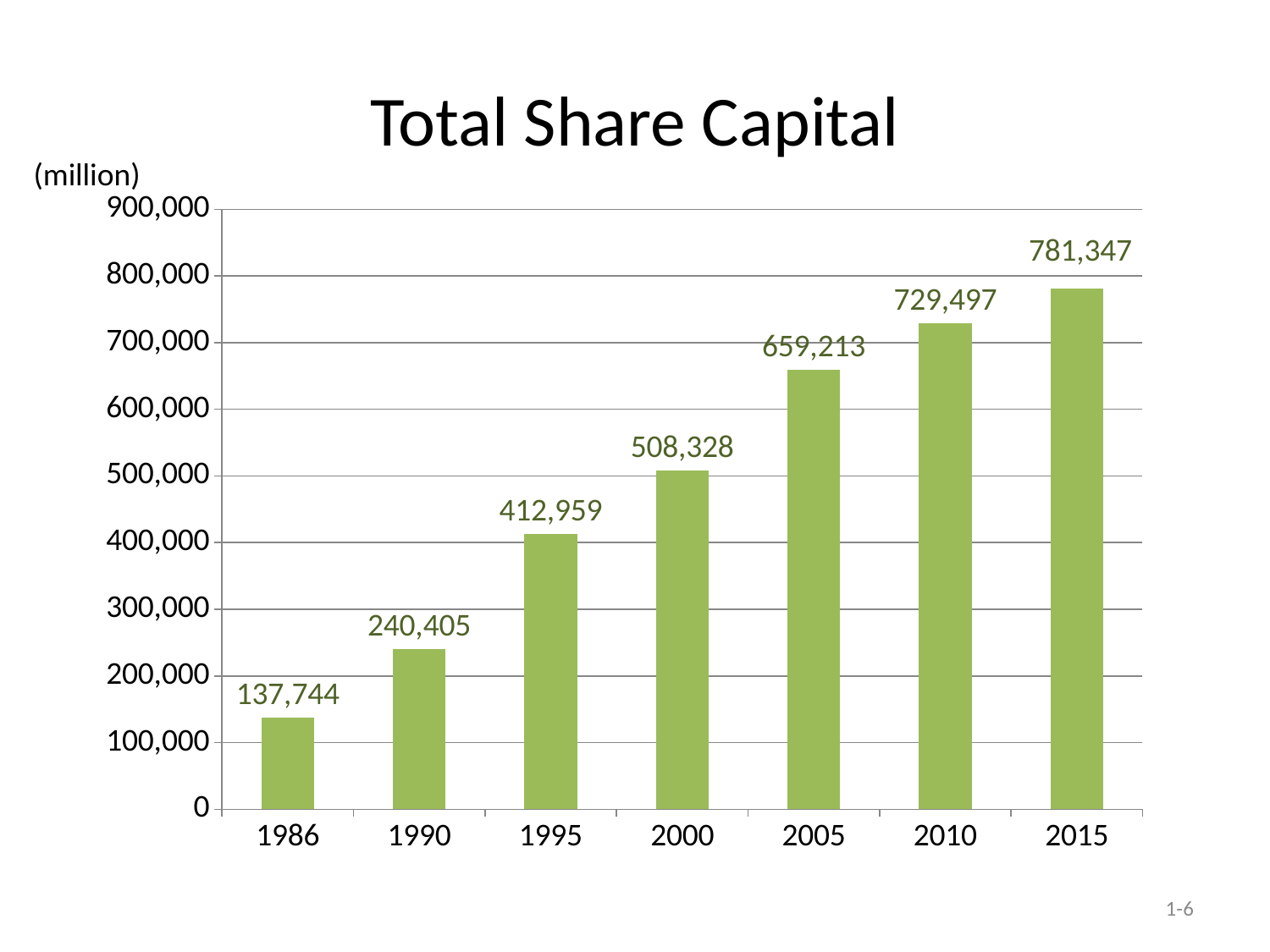
What is the difference between the total share capital in 2015 and in 2010? 51,850 Which year has a larger total share capital, 2005 or 2000? 2005 Do the values rise or fall from 1986 to 2015? Rise What kind of chart is shown on the slide? Bar chart What is the difference between the total share capital in 1995 and in 1990? 172,554 What is the total share capital for 1986? 137,744 How many years are shown on the chart? 7 Which year has the highest total share capital? 2015 What is the total share capital for 2010? 729,497 Is the value for 2005 greater or less than 600,000? greater Which year has the lowest total share capital? 1986 What is the total share capital for 2000? 508,328